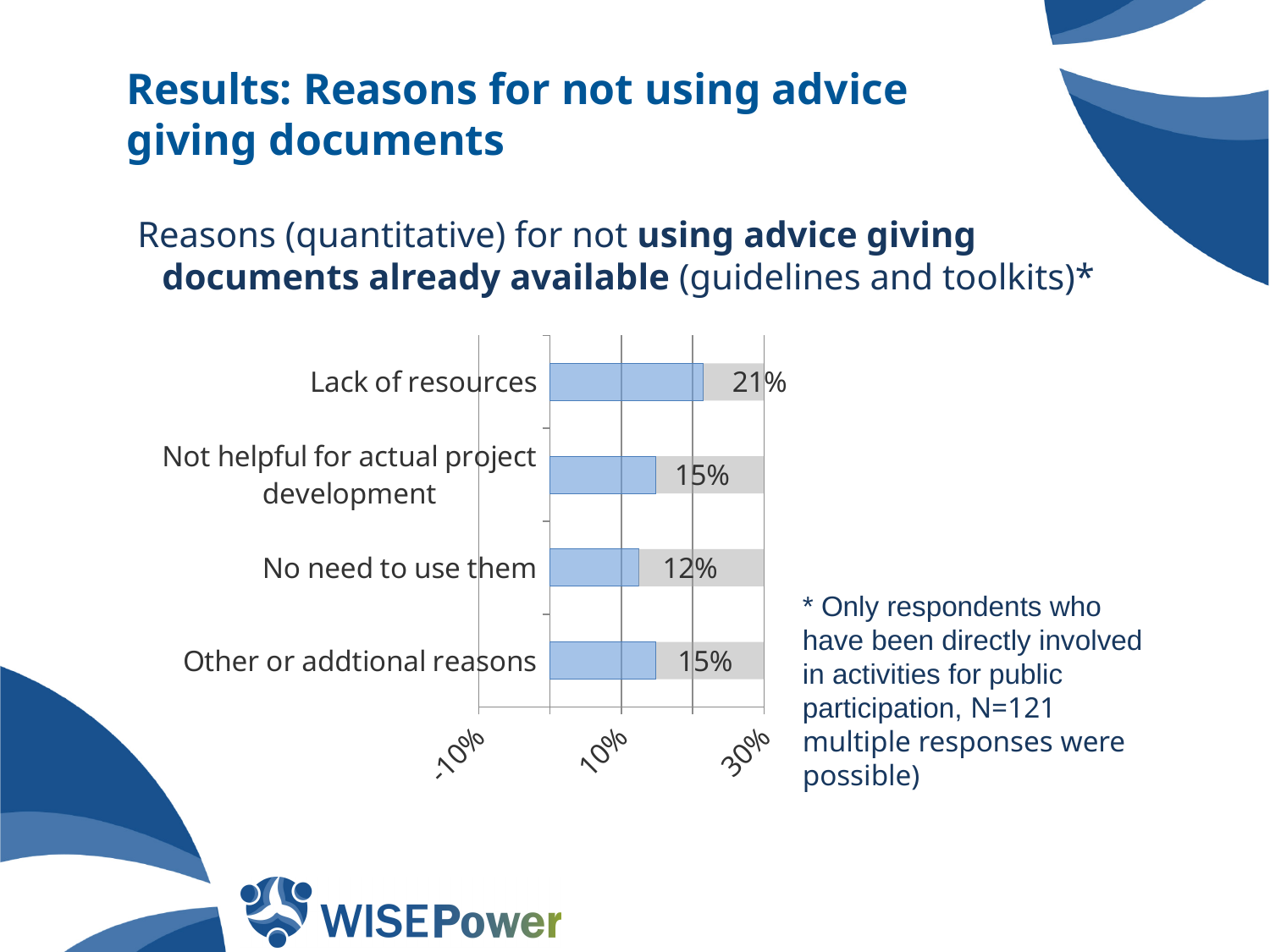
Which reason has the lowest value? No need to use them What is the value for Lack of resources? 21% How many reasons are shown in the chart? 4 What kind of chart is shown on the slide? Bar chart Is the value for Lack of resources greater or less than 10%? greater What is the difference between the values for Lack of resources and Not helpful for actual project development? 6% Which reason has the highest value? Lack of resources What is the value for Not helpful for actual project development? 15% What is the value for Other or addtional reasons? 15% What is the difference between the values for Lack of resources and No need to use them? 9% Which is larger, the value for Lack of resources or the value for No need to use them? Lack of resources What is the value for No need to use them? 12%